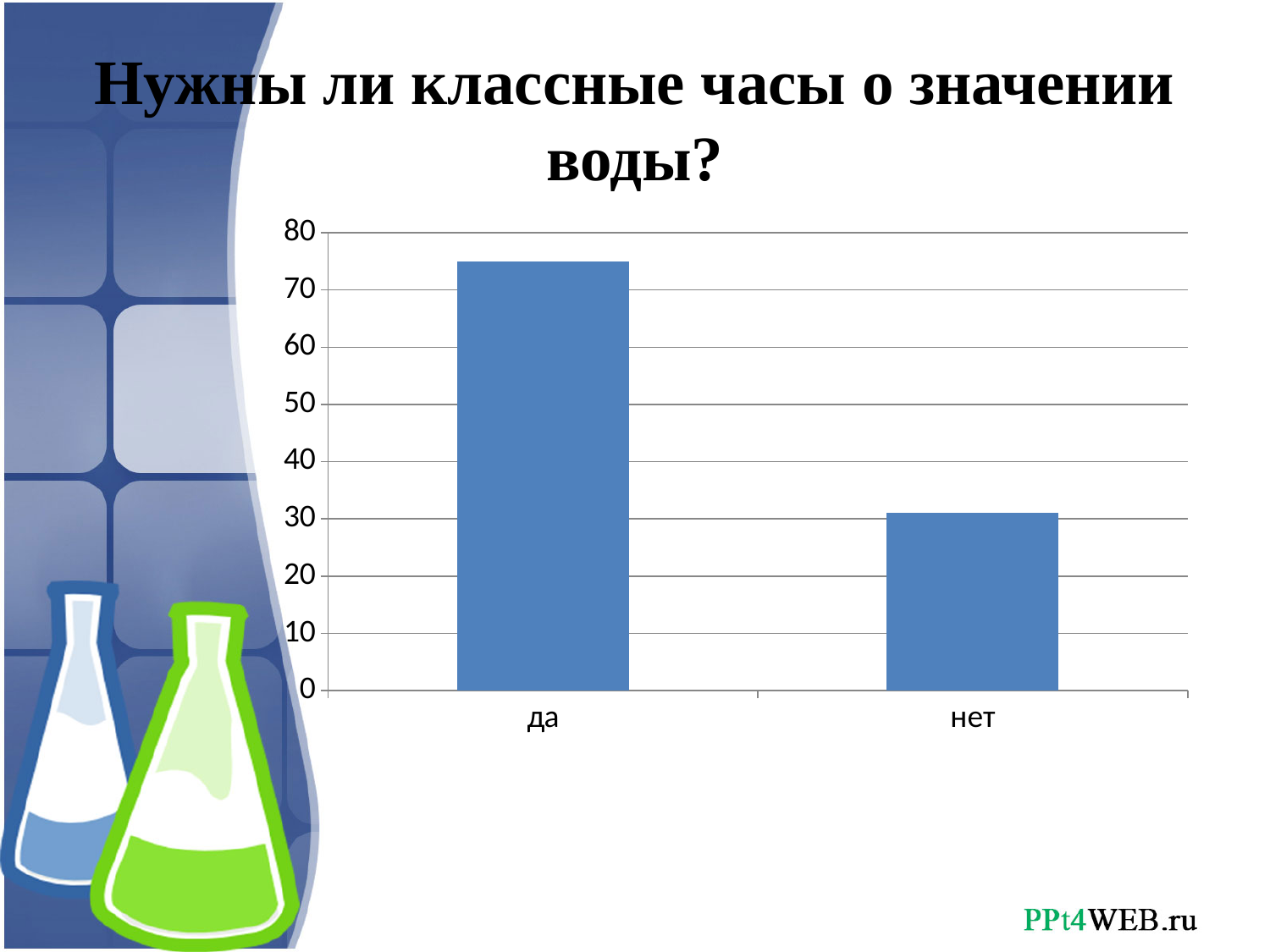
Is the value for "да" greater or less than 80? less What is the title of the slide above the chart? Нужны ли классные часы о значении воды? Which category has the lowest bar in the chart? нет What is the highest value shown on the vertical axis of the chart? 80 Is the value for "нет" greater or less than 20? greater Which bar is taller, "да" or "нет"? да What kind of chart is shown on the slide? bar chart Is the value for "нет" greater or less than 40? less How many categories are shown on the x axis of the chart? 2 Do the values rise or fall moving from "да" to "нет" along the x axis? fall Which category has the highest bar in the chart? да